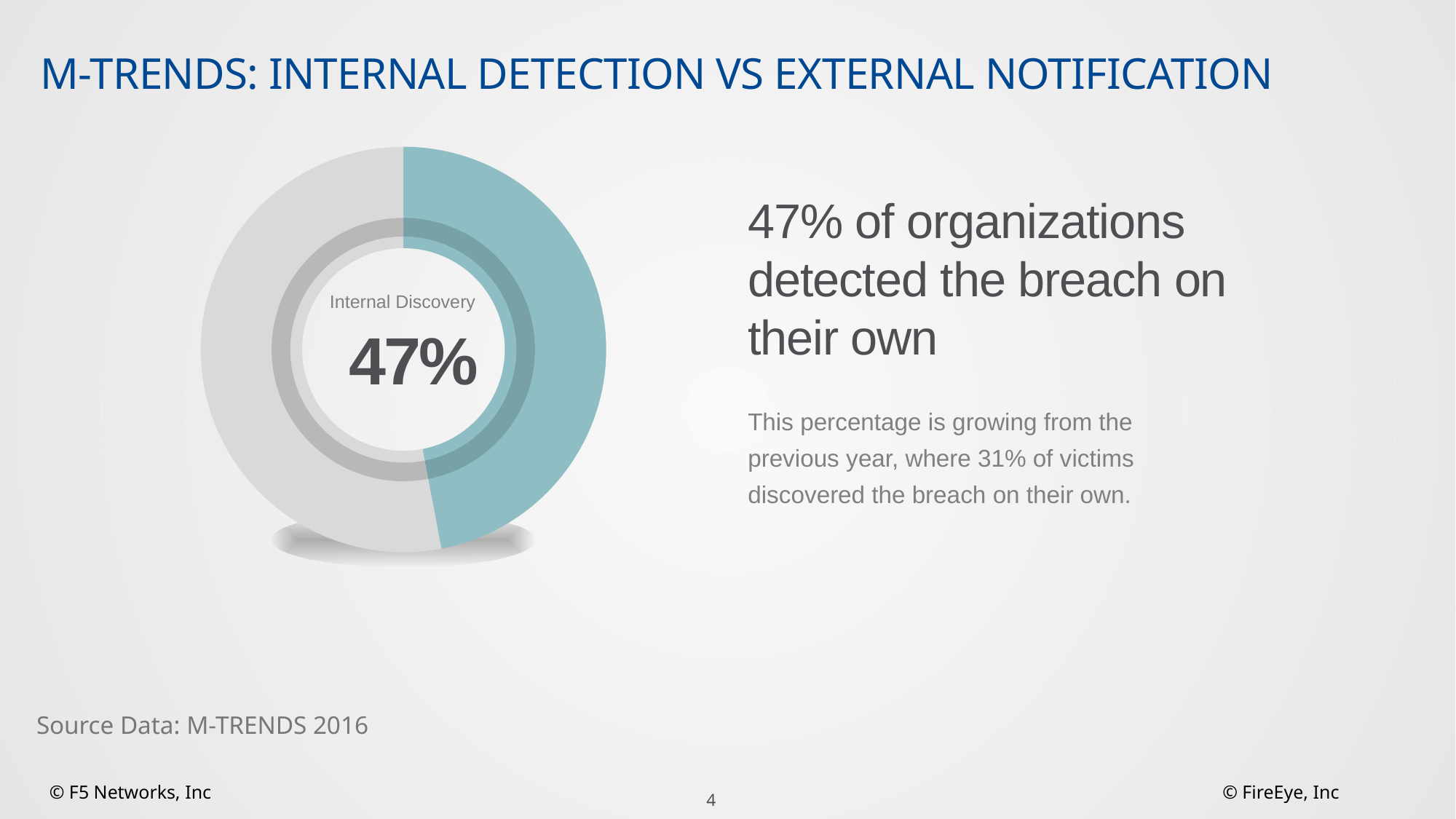
How many segments does the donut chart have? 2 Which segment of the donut chart is larger, the teal Internal Discovery segment or the grey segment? The grey segment What label appears in the centre of the donut chart? Internal Discovery What share of the donut chart does the teal (Internal Discovery) segment represent? 47% What percentage does the donut chart show for Internal Discovery? 47% What is the title of the slide containing the donut chart? M-TRENDS: INTERNAL DETECTION VS EXTERNAL NOTIFICATION Is the Internal Discovery value in the donut chart greater or less than 50%? less What kind of chart is shown on the slide? Donut (pie) chart